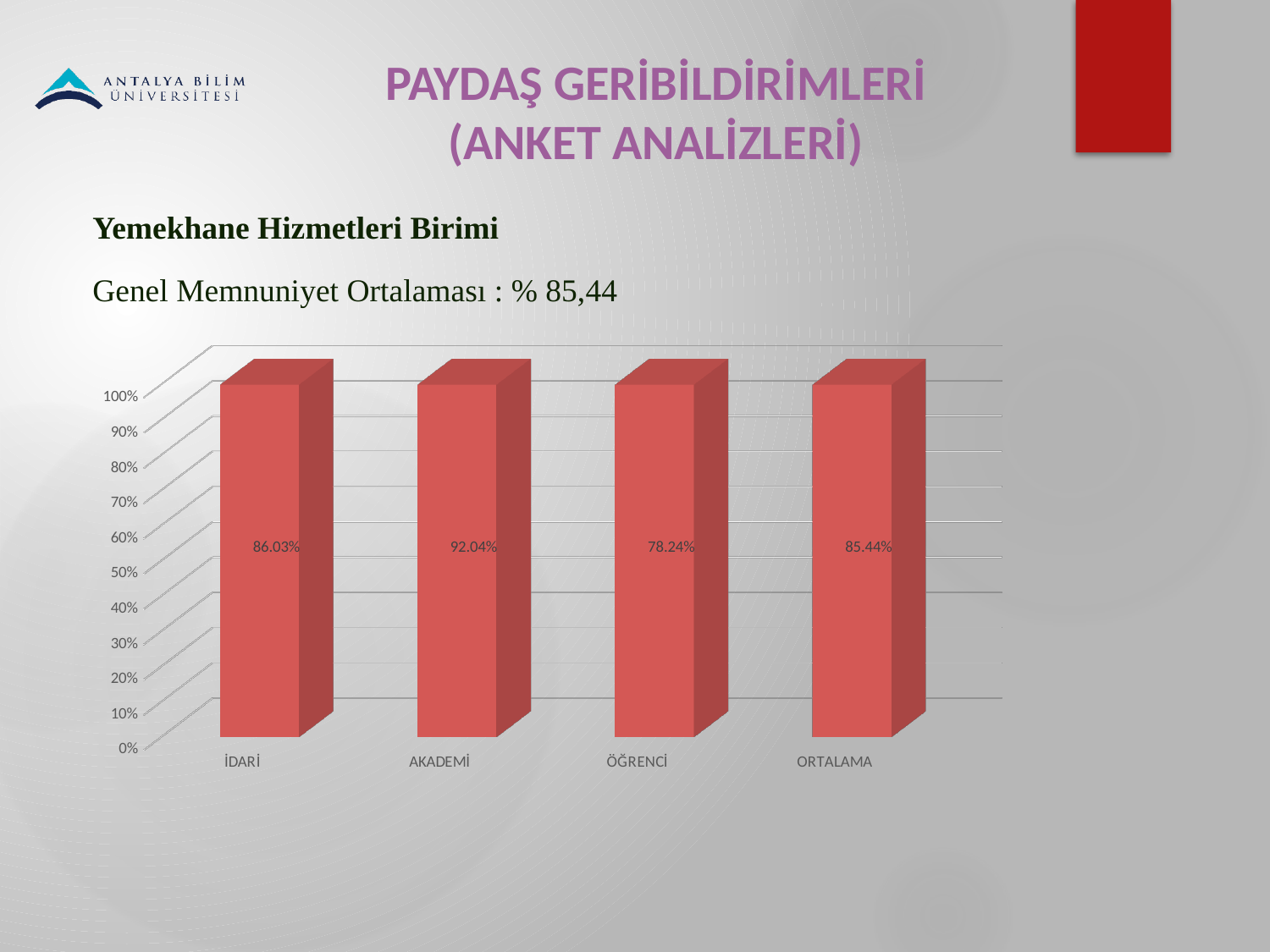
What is the difference between the values for AKADEMİ and ÖĞRENCİ? 13.80% How many categories are shown on the x axis? 4 What is the value for ORTALAMA? 85.44% Which category has the lowest value? ÖĞRENCİ What kind of chart is shown on the slide? Bar chart What is the difference between the values for AKADEMİ and İDARİ? 6.01% What is the value for İDARİ? 86.03% What colour are the bars in the chart? Red Which category has the highest value? AKADEMİ What is the value for ÖĞRENCİ? 78.24% Which is larger, the value for İDARİ or the value for ÖĞRENCİ? İDARİ What is the value for AKADEMİ? 92.04%